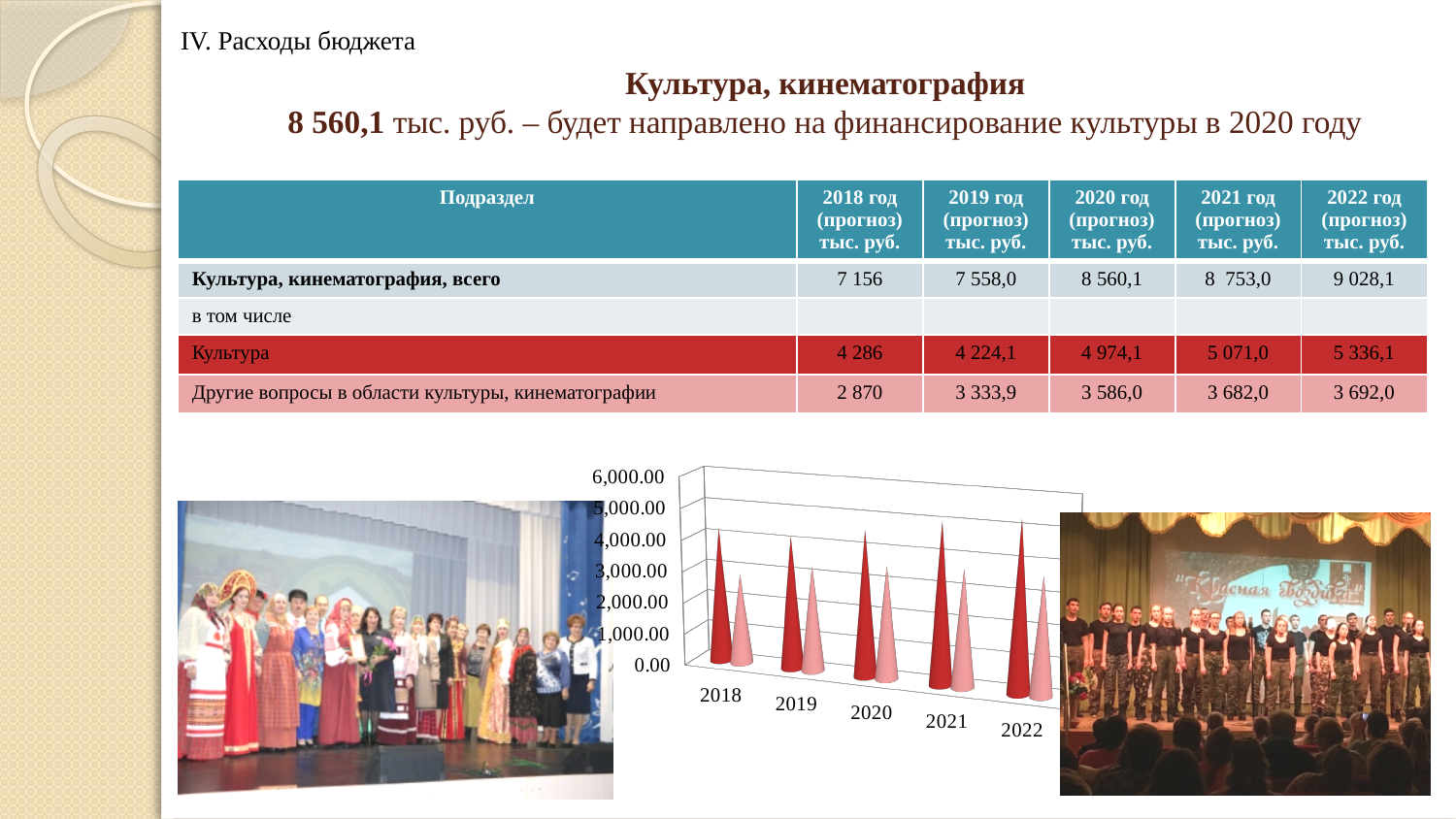
Is the value of the pink series for 2018 greater or less than 4,000.00? less Is the value of the red series for 2022 greater or less than 4,000.00? greater How many data series are plotted in the chart? 2 How many years are shown along the x axis of the chart? 5 In 2018, which series is larger in the chart, the red one or the pink one? red What is the first year shown on the chart's x axis? 2018 Do the values of the pink series rise or fall from 2018 to 2022? rise Is the value of the red series for 2018 greater or less than 3,000.00? greater In which year is the red series at its highest in the chart? 2022 In which year is the pink series at its lowest in the chart? 2018 What kind of chart is shown on the slide? bar chart What is the highest value shown on the chart's vertical axis? 6,000.00